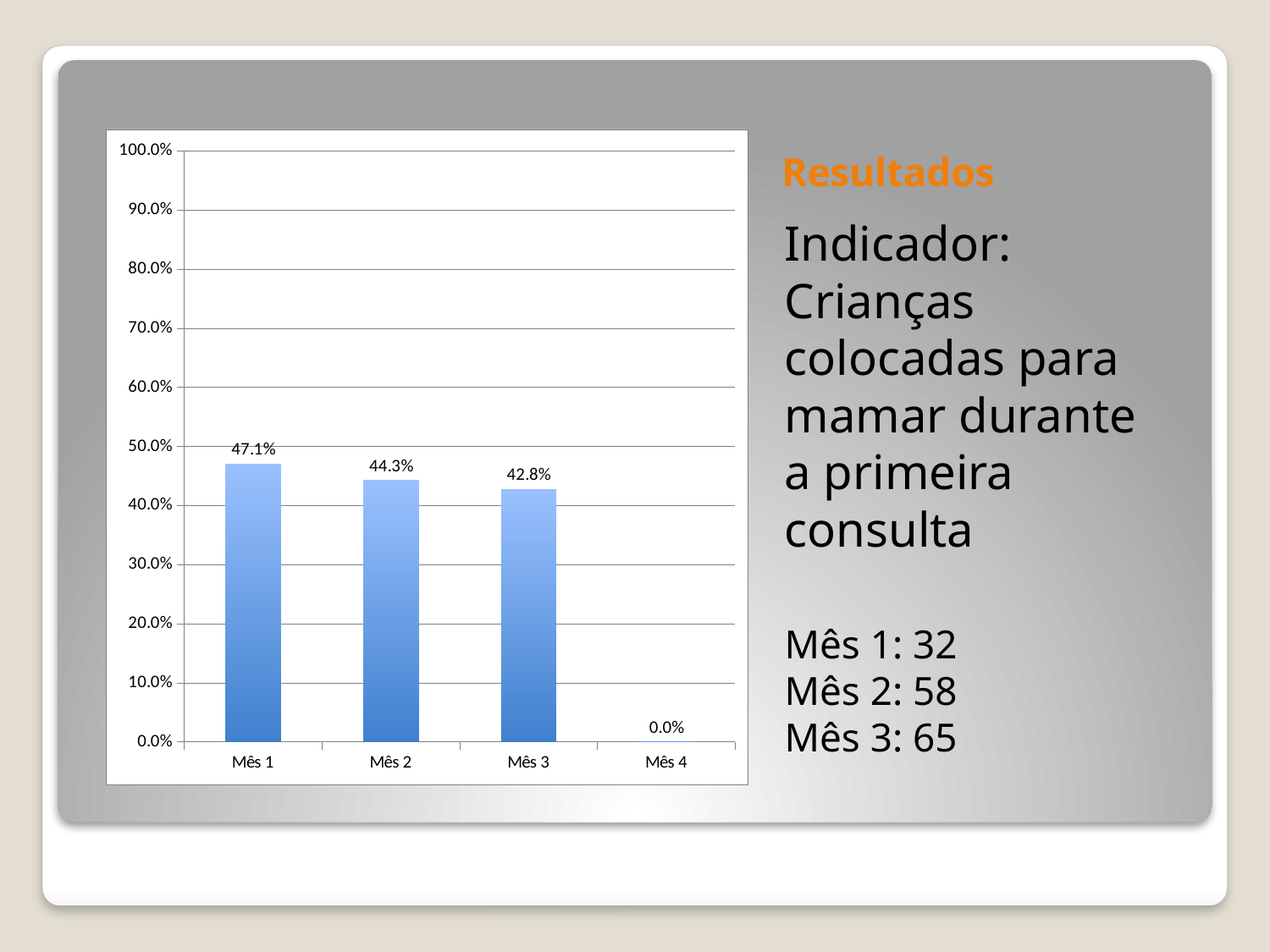
What is the value for Mês 1? 47.1% Which is larger, the value for Mês 2 or the value for Mês 3? Mês 2 What is the value for Mês 2? 44.3% What is the difference between the values for Mês 1 and Mês 3? 4.3% How many categories are shown on the x axis? 4 Which month has the lowest value? Mês 4 Do the values rise or fall from Mês 1 to Mês 4? fall Is the value for Mês 1 greater or less than 50.0%? less What is the value for Mês 4? 0.0% What kind of chart is shown on the slide? bar chart Which month has the highest value? Mês 1 What is the value for Mês 3? 42.8%